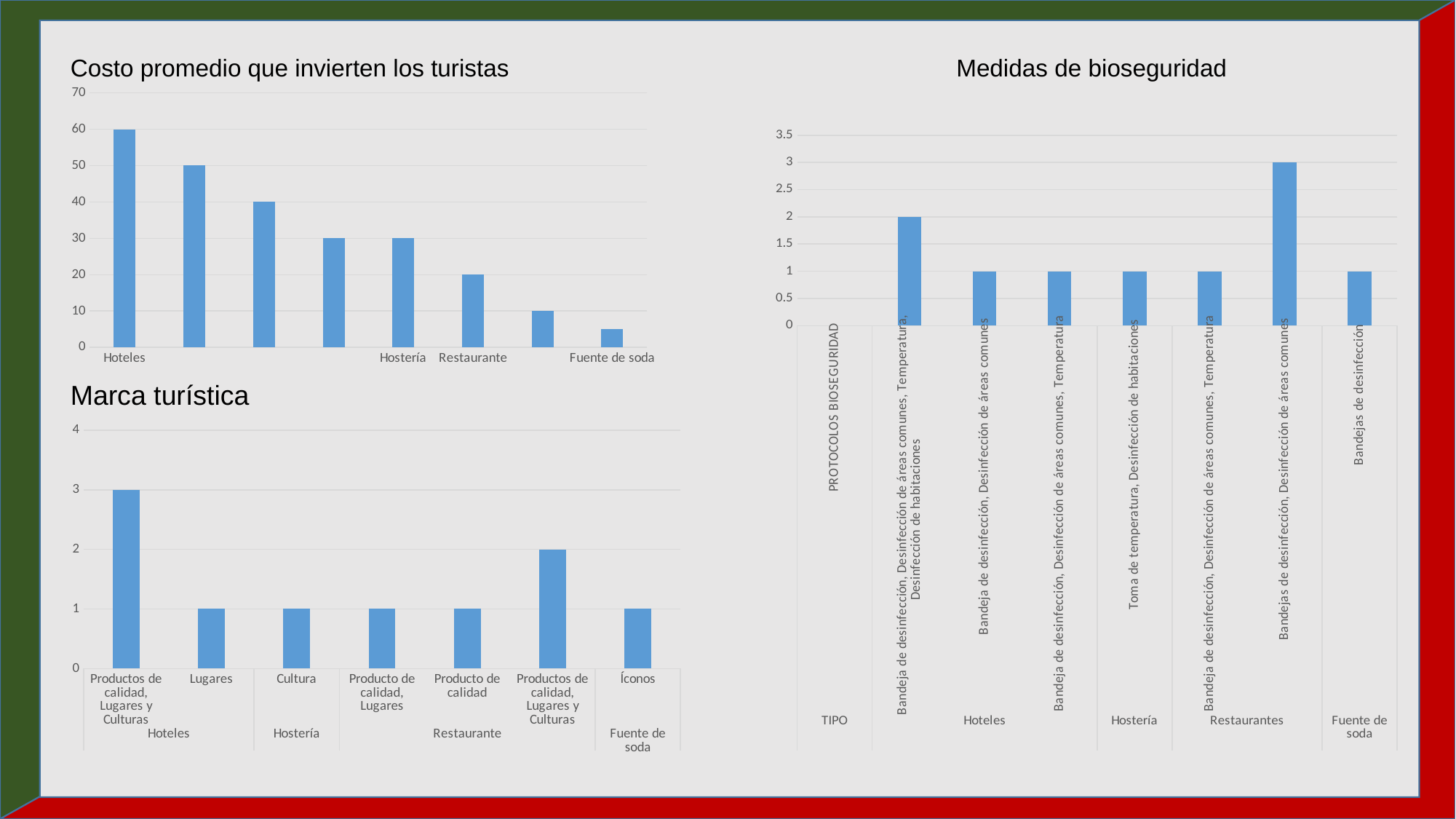
In the 'Costo promedio que invierten los turistas' chart, what is the value for Hoteles? 60 In the 'Marca turística' chart, how many bars are plotted? 7 In the 'Marca turística' chart, which category has the highest value? Productos de calidad, Lugares y Culturas (Hoteles) In the 'Costo promedio que invierten los turistas' chart, do the values rise or fall from left to right? fall In the 'Costo promedio que invierten los turistas' chart, which labelled category has the highest value? Hoteles What type of chart is 'Medidas de bioseguridad'? bar chart In the 'Marca turística' chart, what is the value for Íconos? 1 In the 'Medidas de bioseguridad' chart, what is the value for 'Bandejas de desinfección, Desinfección de áreas comunes' under Restaurantes? 3 In the 'Costo promedio que invierten los turistas' chart, what is the difference between the values for Hoteles and Hostería? 30 In the 'Costo promedio que invierten los turistas' chart, is the value for Fuente de soda greater or less than 10? less In the 'Medidas de bioseguridad' chart, what is the value for 'Toma de temperatura, Desinfección de habitaciones' under Hostería? 1 In the 'Costo promedio que invierten los turistas' chart, what is the value for Restaurante? 20